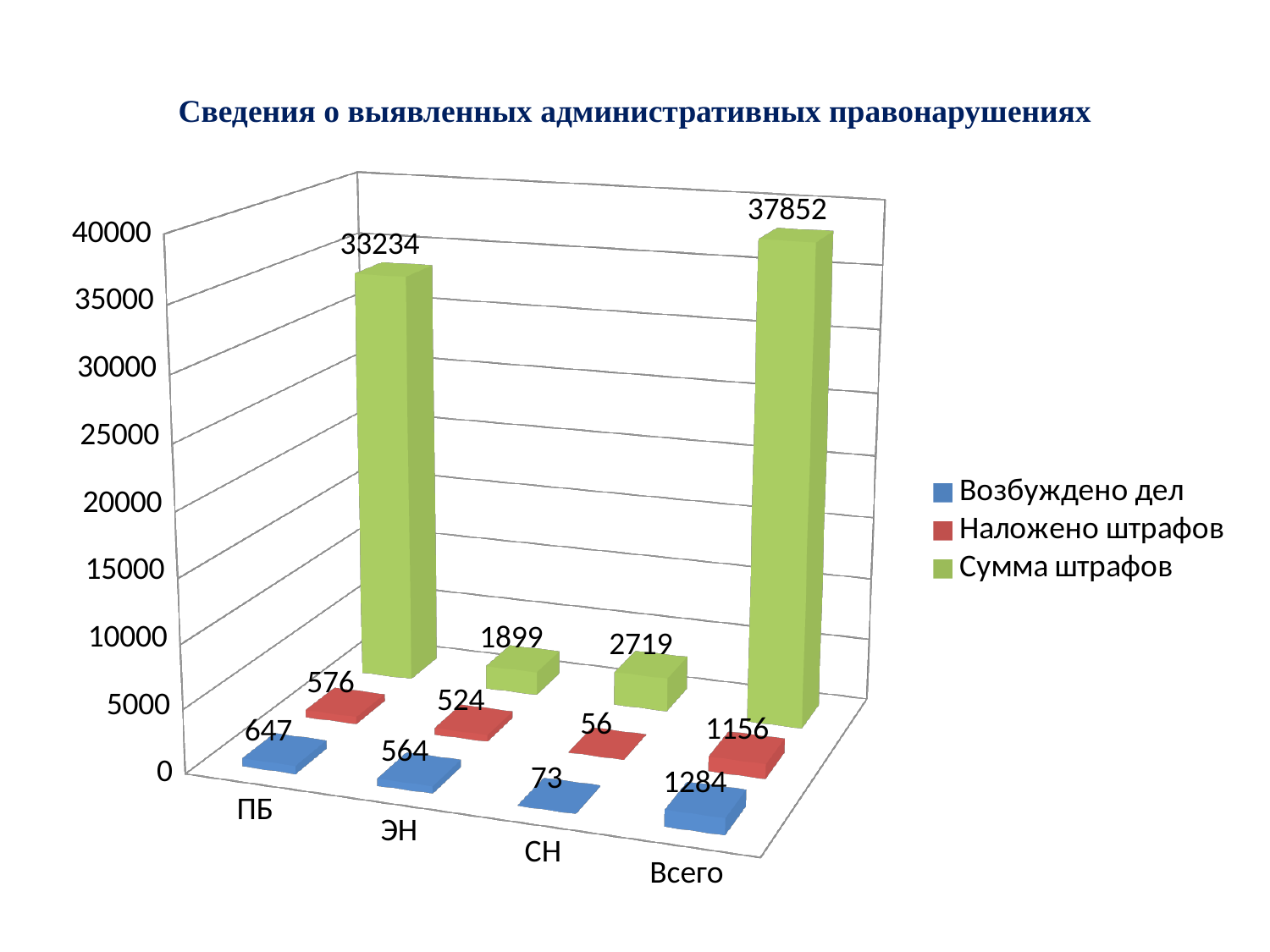
What is the value of Сумма штрафов for СН? 2719 What is the value of Возбуждено дел for ПБ? 647 What is the title of the chart? Сведения о выявленных административных правонарушениях What is the value of Сумма штрафов for Всего? 37852 How many series does the legend list? 3 Which category has the highest value for Сумма штрафов? Всего Which category has the lowest value for Возбуждено дел? СН What is the value of Наложено штрафов for ЭН? 524 How many categories are shown on the x axis? 4 What kind of chart is shown on the slide? Bar chart Which is larger: Возбуждено дел for ЭН or Наложено штрафов for ЭН? Возбуждено дел for ЭН What is the difference between Сумма штрафов for Всего and for ПБ? 4618